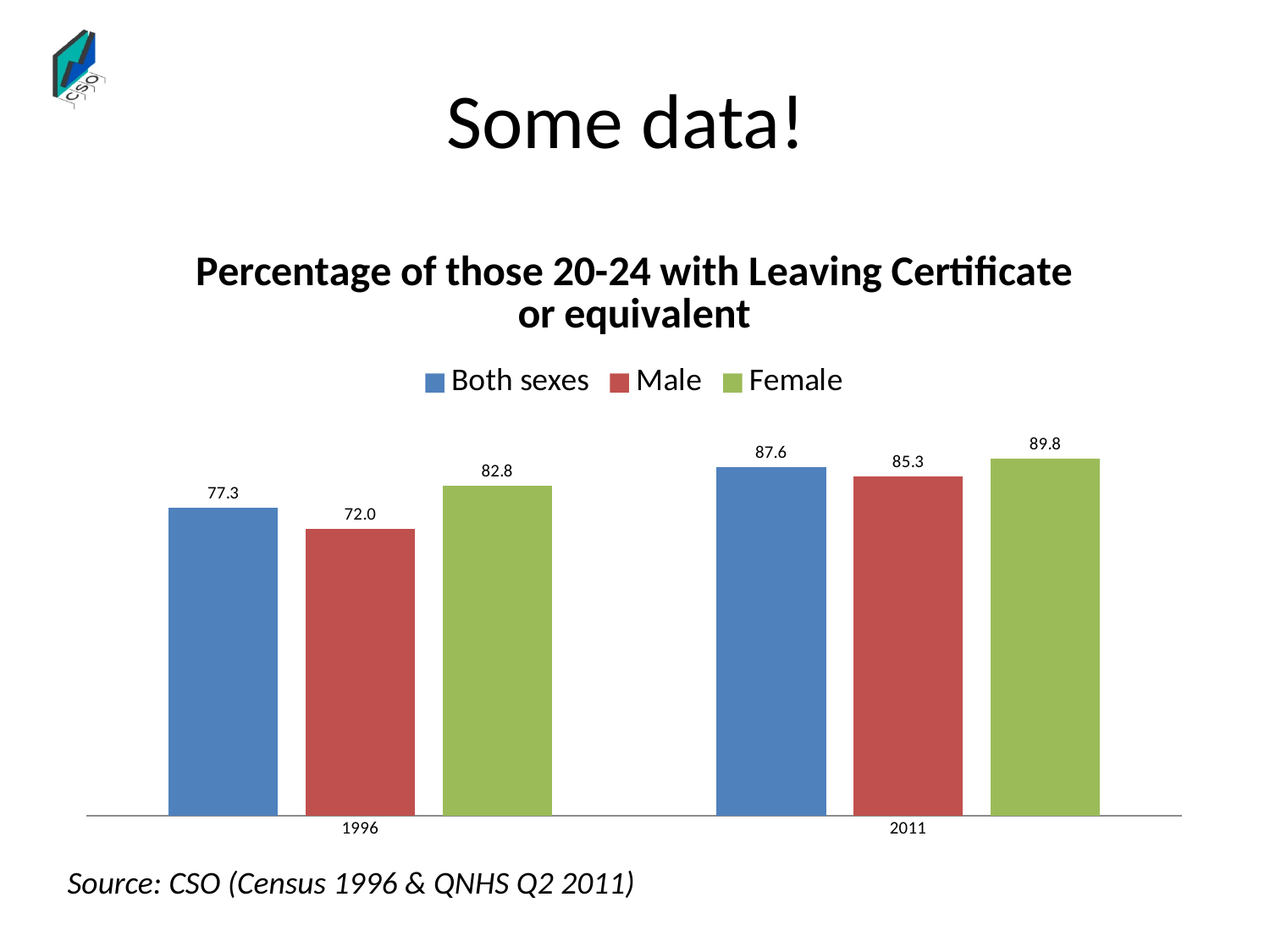
What is the value for Both sexes in 1996? 77.3 What is the difference between the Female and Male values in 1996? 10.8 What is the value for Female in 1996? 82.8 What is the value for Male in 2011? 85.3 What kind of chart is shown on the slide? Bar chart Which series has the highest value in 2011? Female Which series has the lowest value in 1996? Male Do the Male values rise or fall from 1996 to 2011? Rise How many series does the legend list? 3 How many years are shown on the x axis? 2 What is the difference between the Both sexes values in 2011 and 1996? 10.3 Which is larger, the Male value in 2011 or the Female value in 1996? Male value in 2011